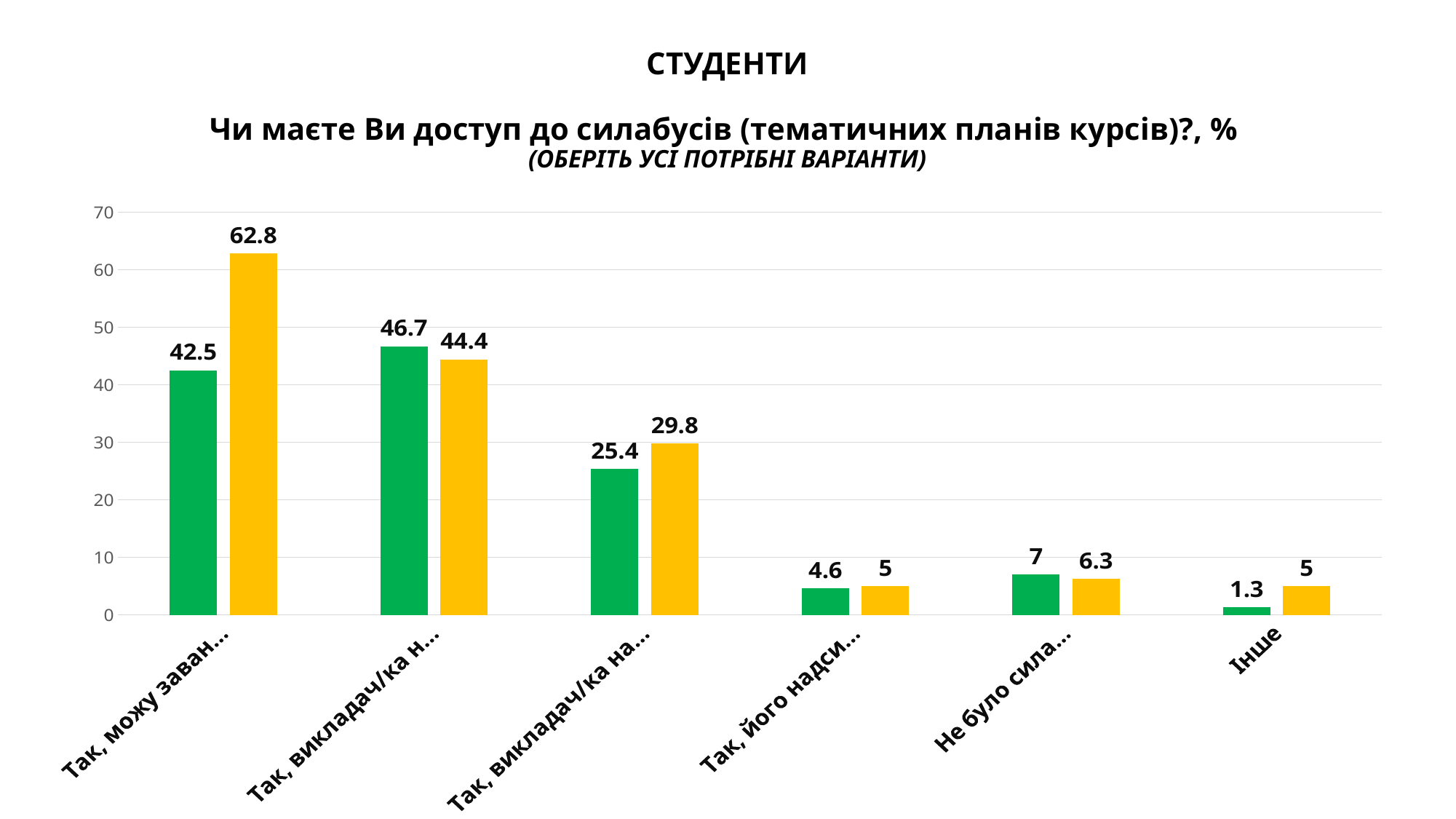
What is the value of the yellow bar for the category "Інше"? 5 Which category has the lowest green bar? Інше What is the difference between the yellow and green bars for the first category on the left? 20.3 For the second category from the left, which bar is larger, the green or the yellow one? green Which category has the highest yellow bar? the first category on the left (Так, можу заван...) What is the difference between the green and yellow bars for the third category from the left? 4.4 What is the value of the yellow bar for the first category on the left? 62.8 How many categories are shown on the x axis of the chart? 6 What is the title of the chart? Чи маєте Ви доступ до силабусів (тематичних планів курсів)?, % What is the value of the green bar for the second category from the left? 46.7 What kind of chart is shown on the slide? bar chart What is the value of the green bar for the category "Інше"? 1.3